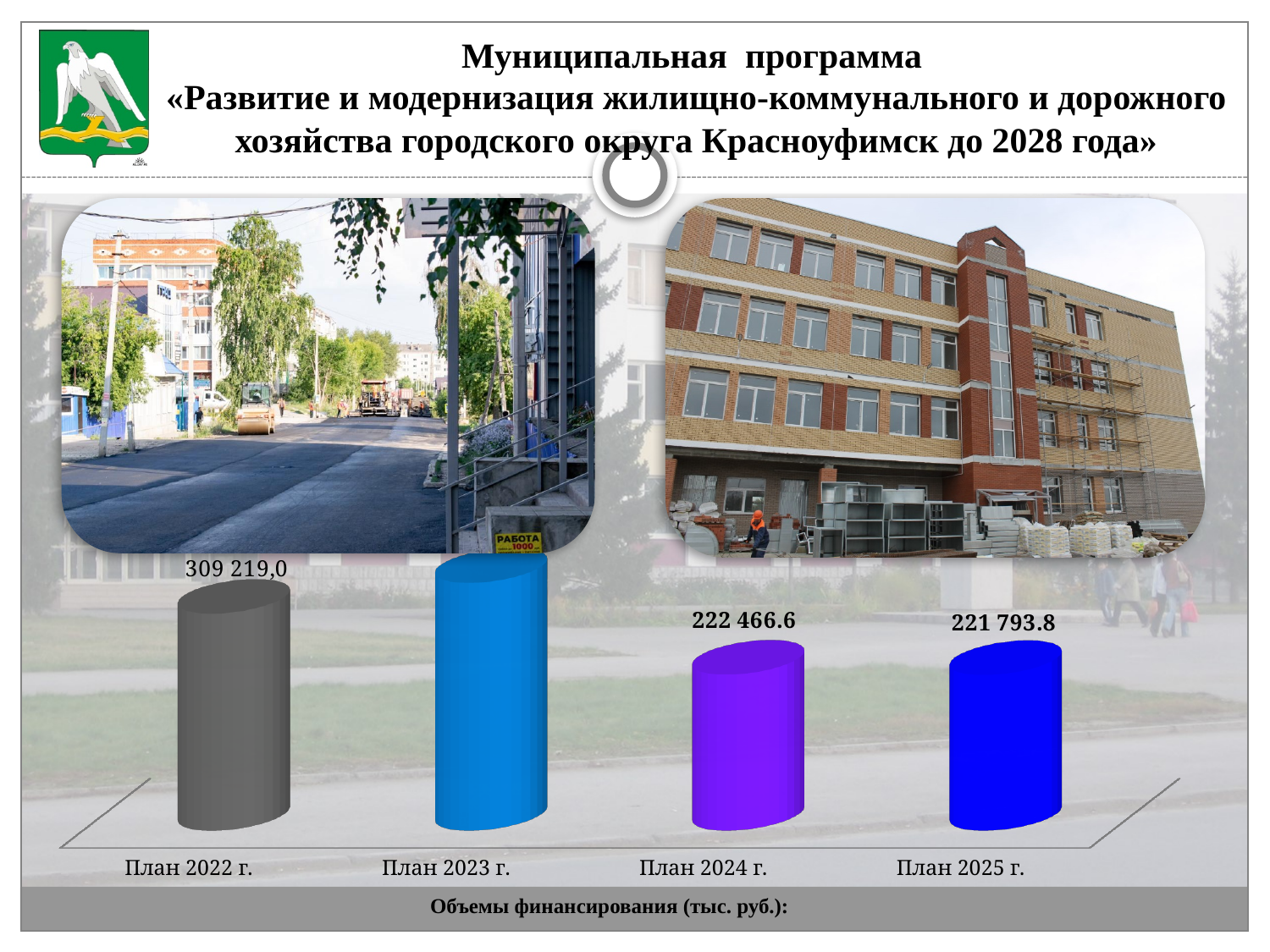
How many categories are shown in the chart? 4 What is the value for План 2025 г.? 221 793.8 What kind of chart is shown on the slide? Bar chart From План 2023 г. to План 2025 г., do the values rise or fall? Fall What is the difference between the values for План 2022 г. and План 2024 г.? 86 752.4 What is the difference between the values for План 2024 г. and План 2025 г.? 672.8 What is the value for План 2022 г.? 309 219,0 Which category has the tallest bar? План 2023 г. What is the value for План 2024 г.? 222 466.6 In what units are the financing volumes given, according to the caption below the chart? тыс. руб. Which is larger, the value for План 2024 г. or План 2025 г.? План 2024 г. Which category has the lowest value? План 2025 г.